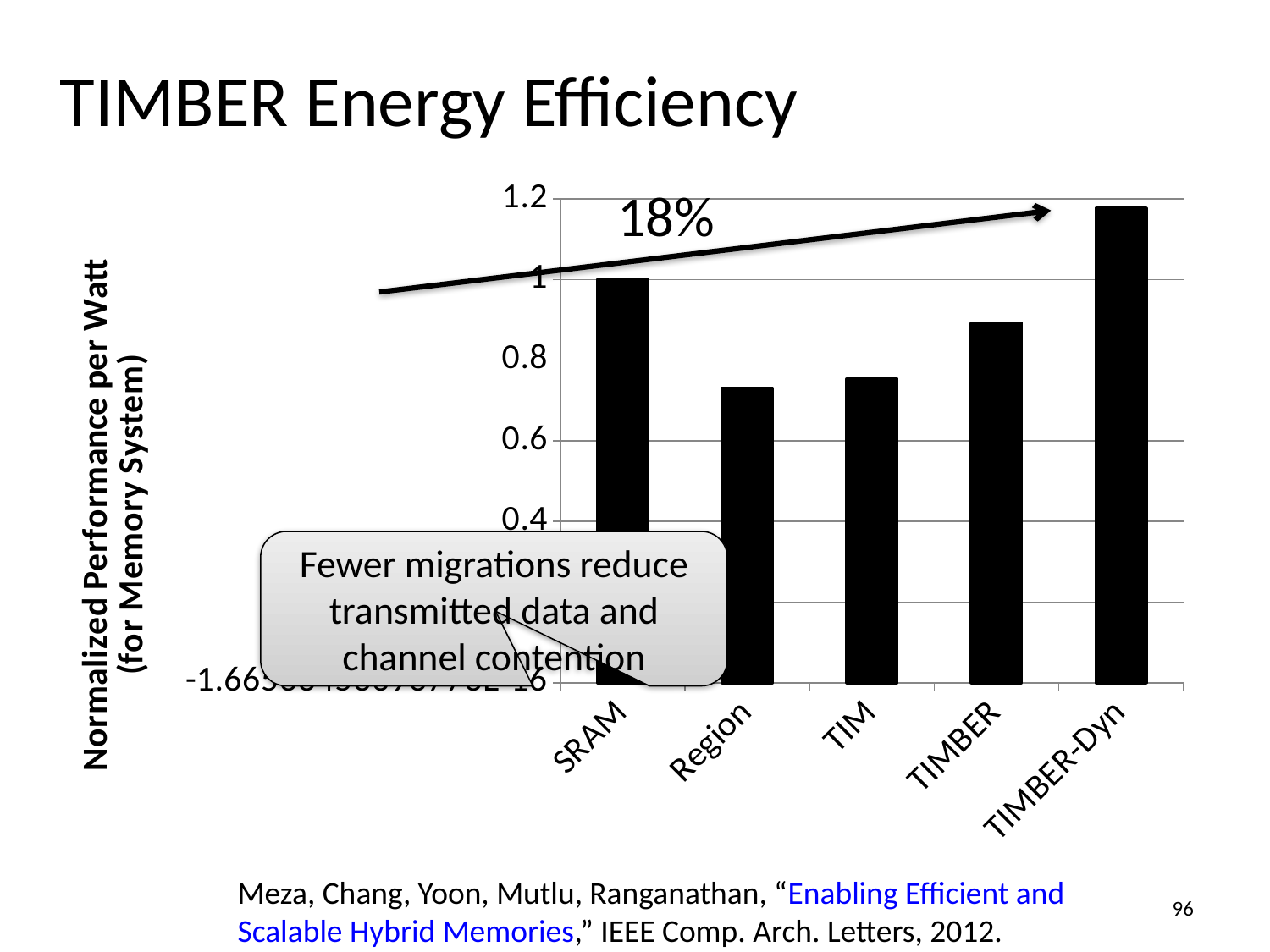
Is the value for TIM greater or less than 0.8? less Which has a larger normalized performance per watt, SRAM or Region? SRAM What kind of chart is shown on the slide? bar chart What is the normalized performance per watt for SRAM? 1 Is the value for TIMBER-Dyn greater or less than 1? greater What is the label of the y axis of the chart? Normalized Performance per Watt (for Memory System) Which has a larger normalized performance per watt, TIMBER or TIM? TIMBER Is the value for Region greater or less than 0.8? less How many categories are shown on the x axis of the chart? 5 What percentage improvement is annotated with the arrow on the chart? 18% Which category has the highest normalized performance per watt? TIMBER-Dyn